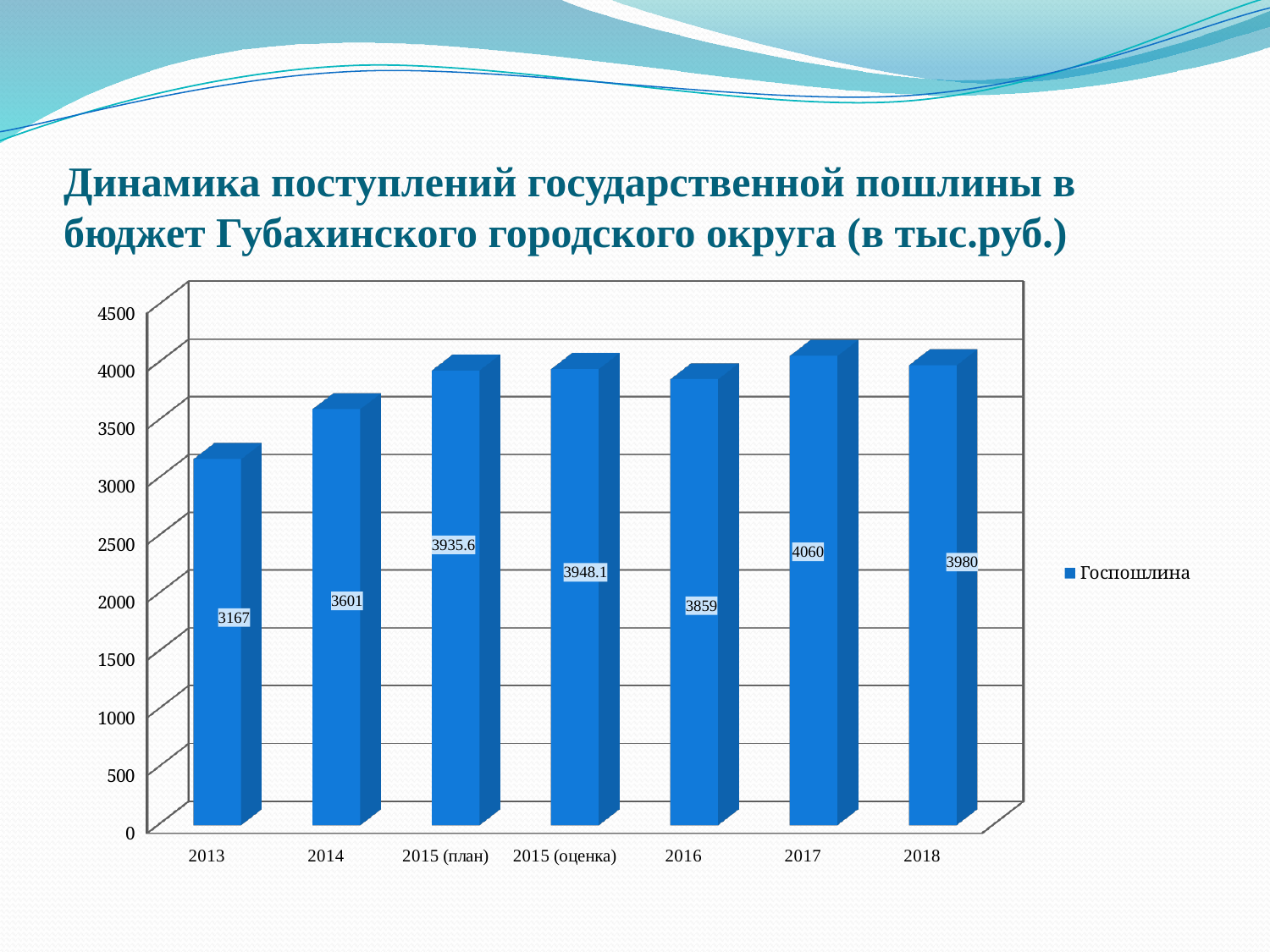
What is the difference between the values for 2014 and 2013? 434 What kind of chart is shown on the slide? bar chart Is the value for 2014 greater or less than 3500? greater Which year has the lowest value? 2013 What is the value for 2013? 3167 What is the legend entry for the series? Госпошлина How many categories are shown on the x axis? 7 Which year has the highest value? 2017 What is the value for 2017? 4060 How many series does the legend list? 1 What is the value for 2015 (план)? 3935.6 Which is larger, the value for 2016 or the value for 2018? 2018